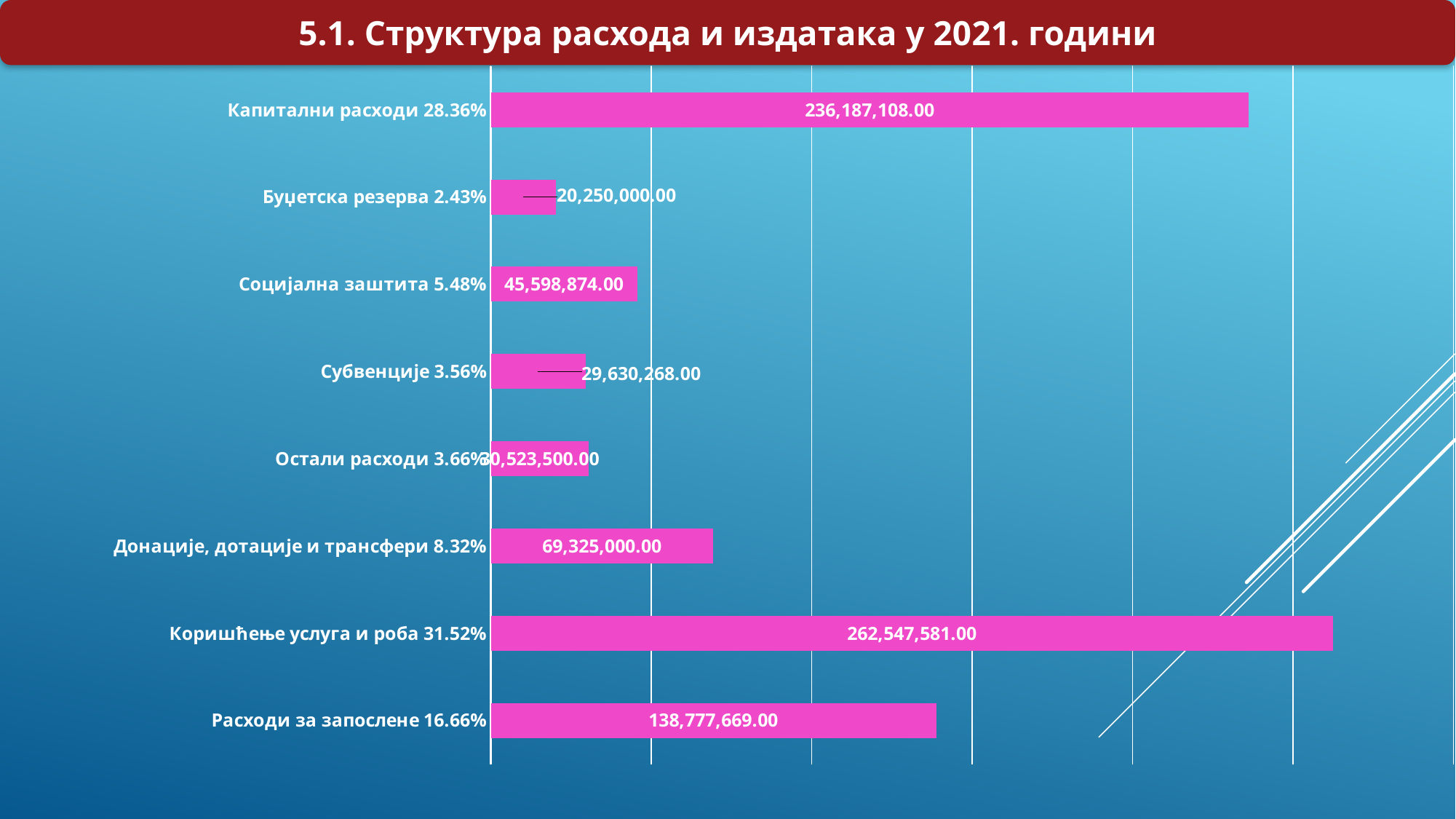
What is the difference between the values for Коришћење услуга и роба and Капитални расходи? 26,360,473.00 What is the title of the slide? 5.1. Структура расхода и издатака у 2021. години Which category has the highest value? Коришћење услуга и роба Which category has the lowest value? Буџетска резерва What type of chart is shown on the slide? Bar chart How many categories are shown in the chart? 8 What is the value for Коришћење услуга и роба? 262,547,581.00 What is the value for Капитални расходи? 236,187,108.00 What is the value for Расходи за запослене? 138,777,669.00 What is the value for Социјална заштита? 45,598,874.00 Which is larger, the value for Субвенције or the value for Социјална заштита? Социјална заштита What is the value for Донације, дотације и трансфери? 69,325,000.00